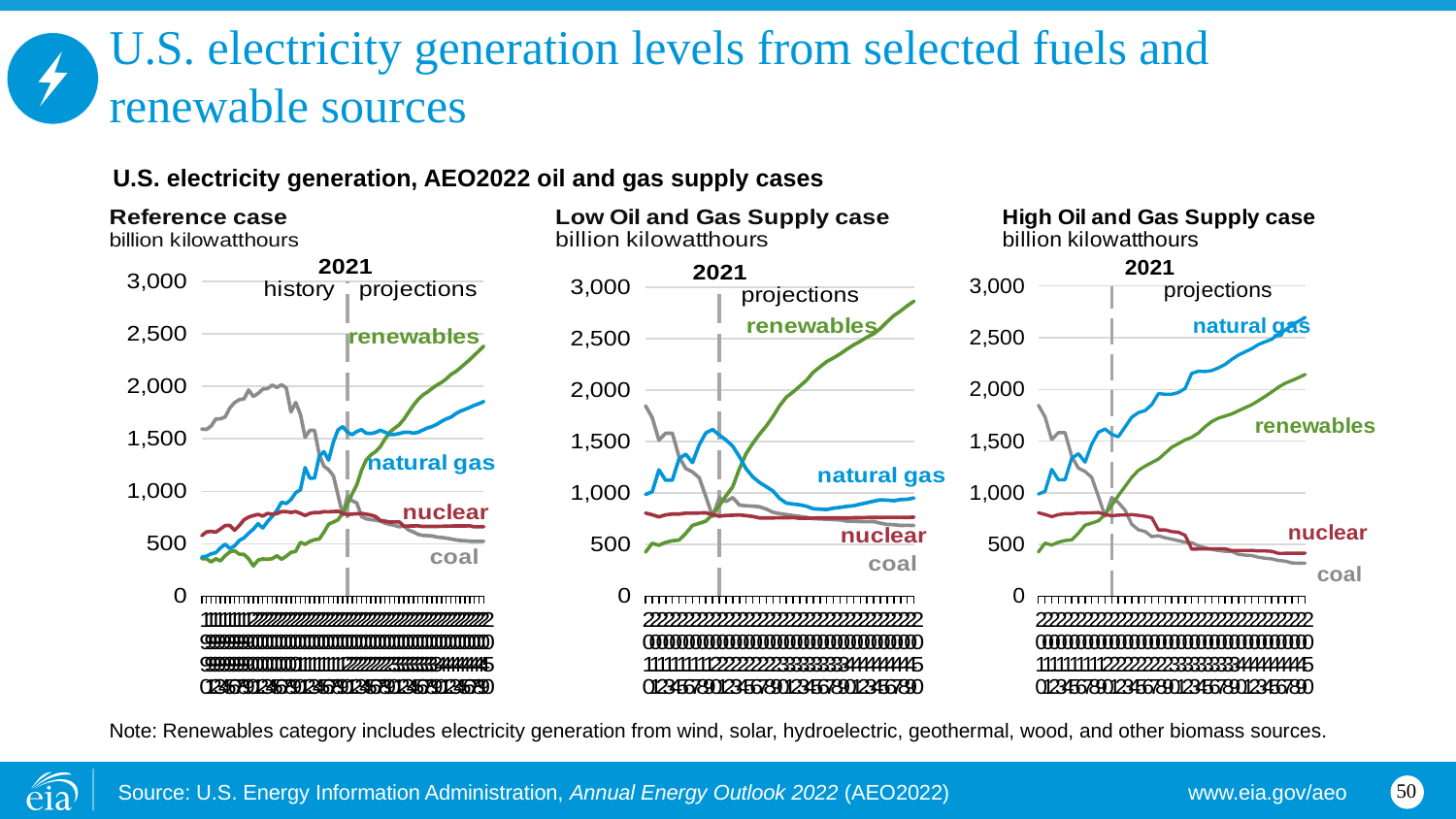
What type of chart is used for the Reference case? line chart In the Low Oil and Gas Supply case chart, which series is highest at the end of the projection period? renewables In the High Oil and Gas Supply case chart, which series is highest at the end of the projection period? natural gas What year marks the boundary between history and projections in the charts? 2021 In the Reference case chart, which series is highest at the end of the projection period? renewables In the High Oil and Gas Supply case chart, which series is lowest at the end of the projection period? coal In the Reference case chart, at the end of the projection period, which is larger: natural gas or nuclear? natural gas In the Low Oil and Gas Supply case chart, is the value for coal at the end of the projection period greater or less than 1,000? less In the Low Oil and Gas Supply case chart, is the value for renewables at the end of the projection period greater or less than 2,500? greater In the Reference case chart, how many fuel series are plotted? 4 In the Low Oil and Gas Supply case chart, does natural gas generation rise or fall over the projection period? fall In the Reference case chart, is the value for renewables at the end of the projection period greater or less than 2,000? greater